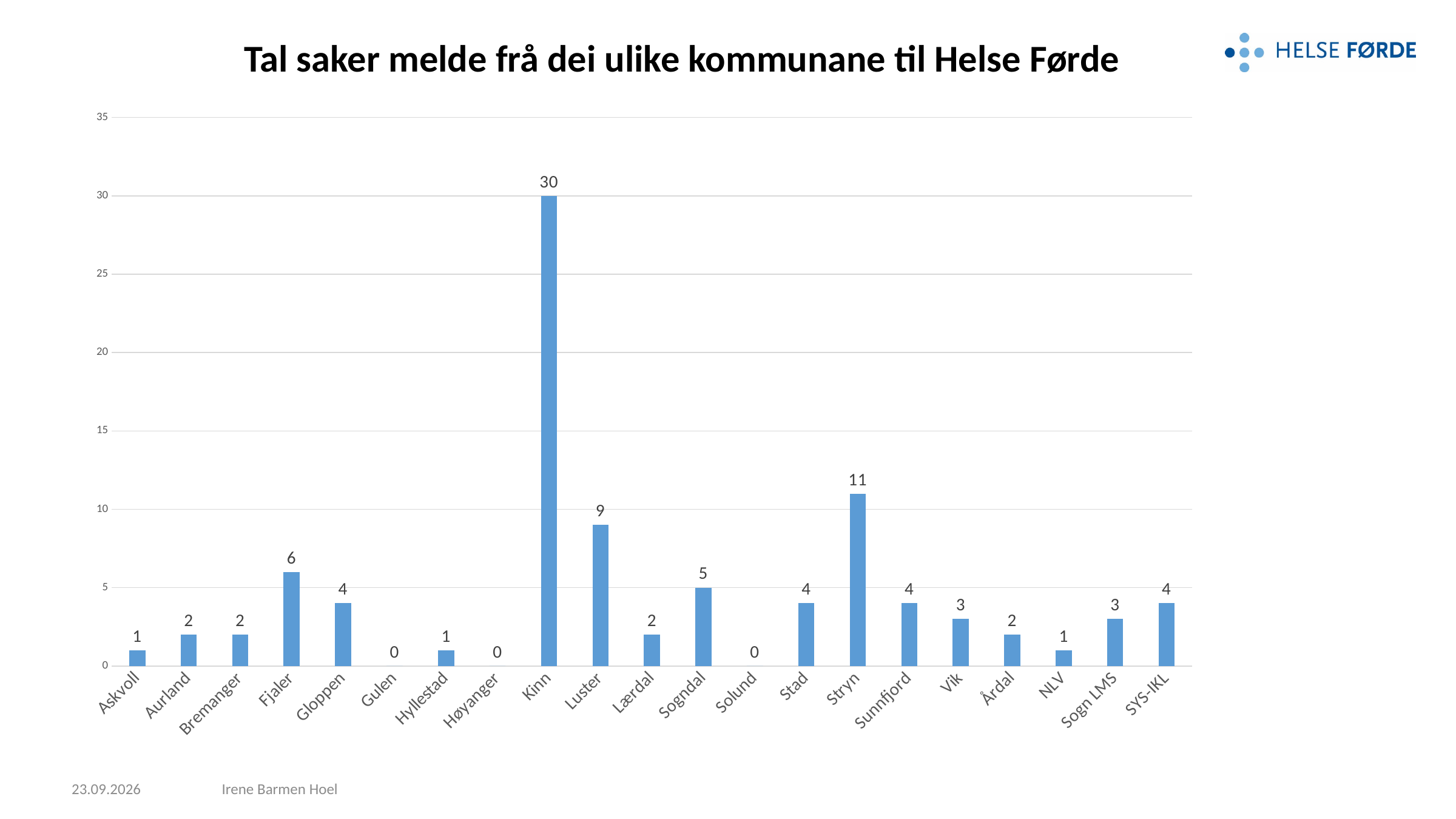
What kind of chart is shown on the slide? Bar chart What is the value for Fjaler? 6 What is the value for Kinn? 30 What is the difference between the values for Luster and Sogndal? 4 How many categories are shown on the x axis? 21 Is the value for Kinn greater or less than 25? greater What is the title of the chart? Tal saker melde frå dei ulike kommunane til Helse Førde Which is larger, the value for Fjaler or the value for Gloppen? Fjaler What is the value for Sogn LMS? 3 Which category has the highest value? Kinn What is the value for Stryn? 11 What is the difference between the values for Kinn and Stryn? 19